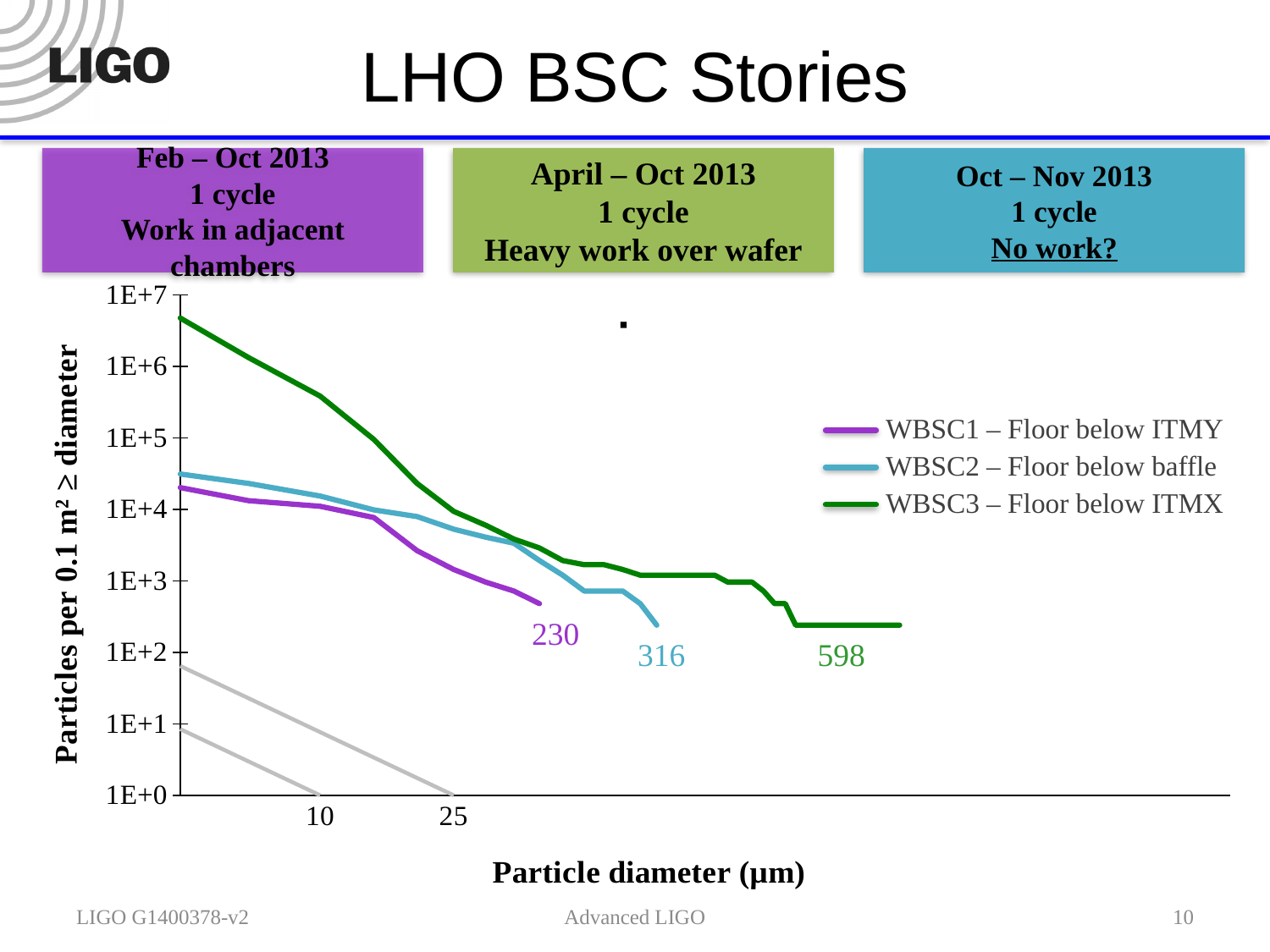
Which series has the highest value at the smallest particle diameter? WBSC3 – Floor below ITMX Is the value for WBSC3 – Floor below ITMX at the smallest particle diameter greater or less than 1E+6? greater Is the value for WBSC2 – Floor below baffle at the smallest particle diameter greater or less than 1E+4? greater Which series extends to the largest particle diameter on the chart? WBSC3 – Floor below ITMX At a particle diameter of 10 µm, which series has the larger value: WBSC3 – Floor below ITMX or WBSC1 – Floor below ITMY? WBSC3 – Floor below ITMX What is the label on the y axis of the chart? Particles per 0.1 m² ≥ diameter Which series is drawn in green? WBSC3 – Floor below ITMX How many series does the chart legend list? 3 What kind of chart is shown on the slide? line chart Is the value for WBSC1 – Floor below ITMY at the smallest particle diameter greater or less than 1E+5? less Do the plotted values rise or fall as particle diameter increases? fall